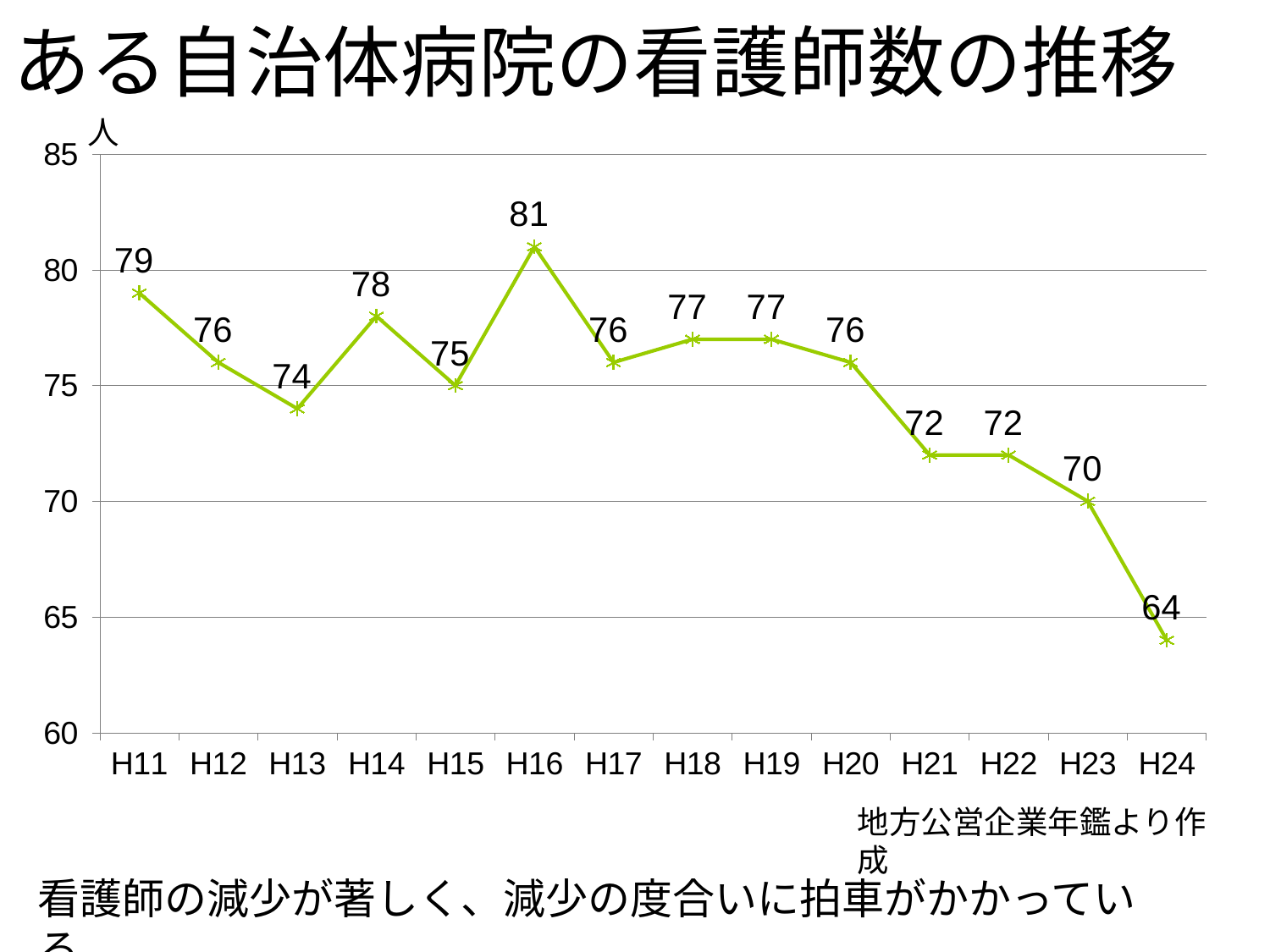
Which is larger, the value for H14 or the value for H20? H14 What is the difference between the values for H16 and H17? 5 What kind of chart is shown on the slide? line chart What is the number of nurses in H24? 64 Which year has the lowest number of nurses? H24 What is the difference between the values for H11 and H24? 15 What is the value for H13? 74 What is the number of nurses in H16? 81 Overall, do the values rise or fall from H11 to H24? fall What is the title of the chart? ある自治体病院の看護師数の推移 How many years are plotted on the x axis? 14 Which year has the highest number of nurses? H16